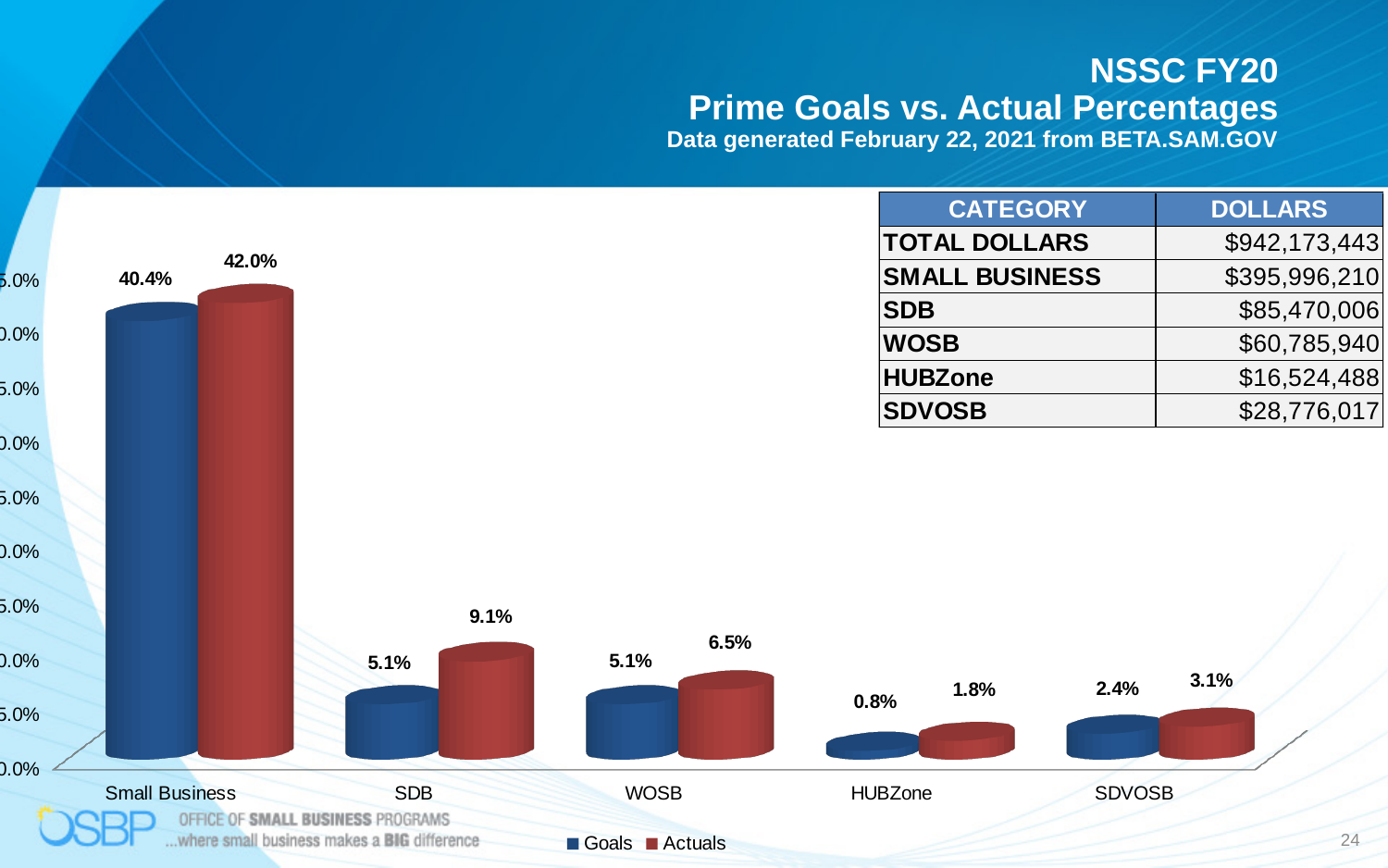
What is the Actuals value for Small Business? 42.0% Which is larger for WOSB, the Goals value or the Actuals value? Actuals What is the Goals value for SDB? 5.1% Which category has the highest Actuals value? Small Business How many series does the chart legend list? 2 What is the Goals value for SDVOSB? 2.4% How many categories are shown on the x axis of the chart? 5 What is the difference between the Actuals and Goals values for SDB? 4.0% What is the Actuals value for HUBZone? 1.8% What are the two series named in the chart legend? Goals and Actuals Which category has the lowest Goals value? HUBZone What kind of chart is shown on the slide? Bar chart